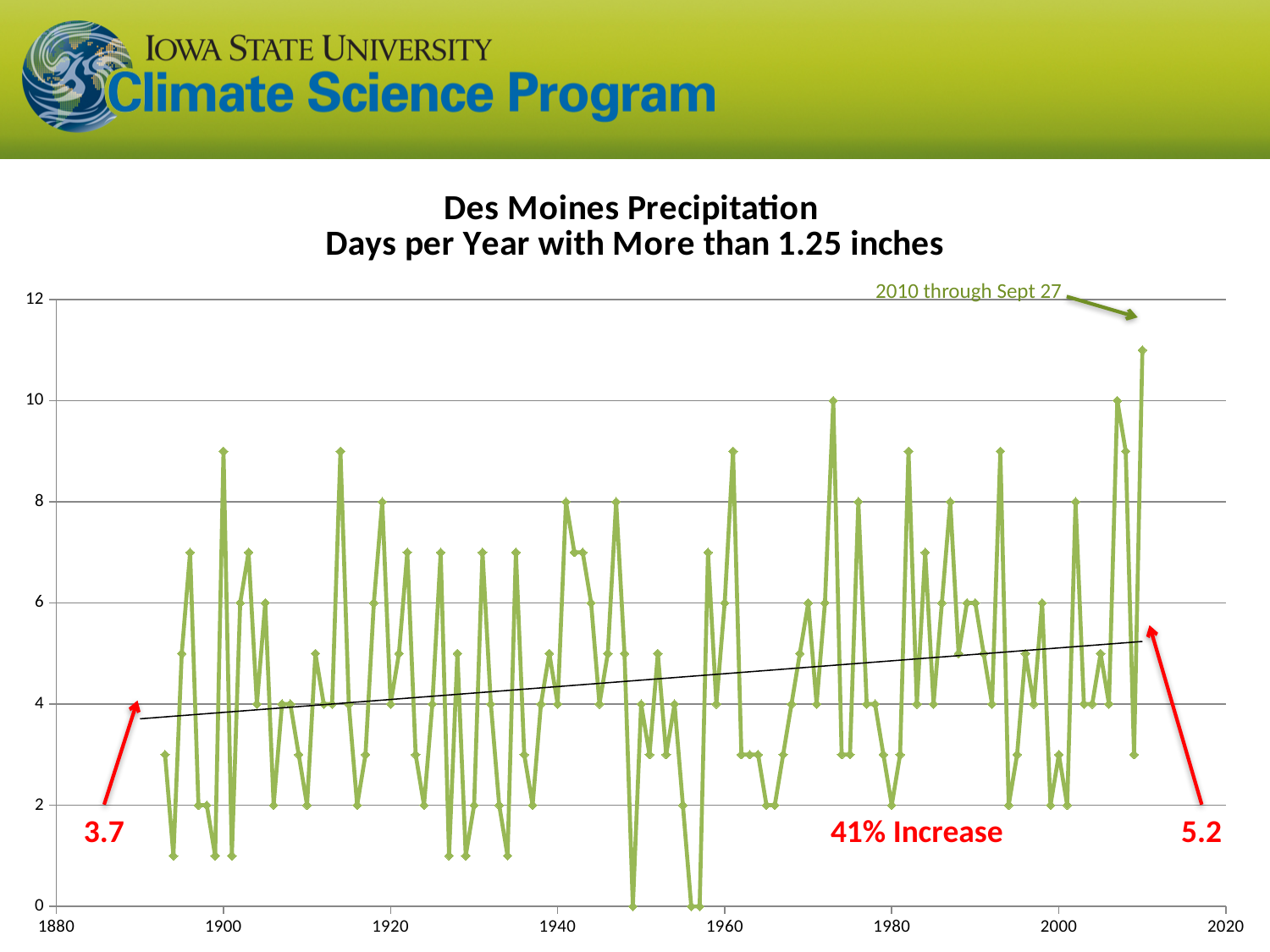
What kind of chart is shown on the slide? Line chart What does the annotation pointing to the last data point say? 2010 through Sept 27 What value is labeled at the end of the trend line on the right side of the chart? 5.2 What is the difference between the trend line's end value (5.2) and its start value (3.7)? 1.5 What is the title of the chart? Des Moines Precipitation Days per Year with More than 1.25 inches What value is labeled at the start of the trend line on the left side of the chart? 3.7 Is the value plotted for 2010 greater or less than 10? greater Which is larger, the trend line value at the start (3.7) or at the end (5.2)? 5.2 Does the trend line rise or fall from 1890 to 2010? Rises What is the lowest value reached by the plotted line? 0 What percentage increase is annotated on the chart? 41% Increase Which year has the highest number of days plotted on the chart? 2010